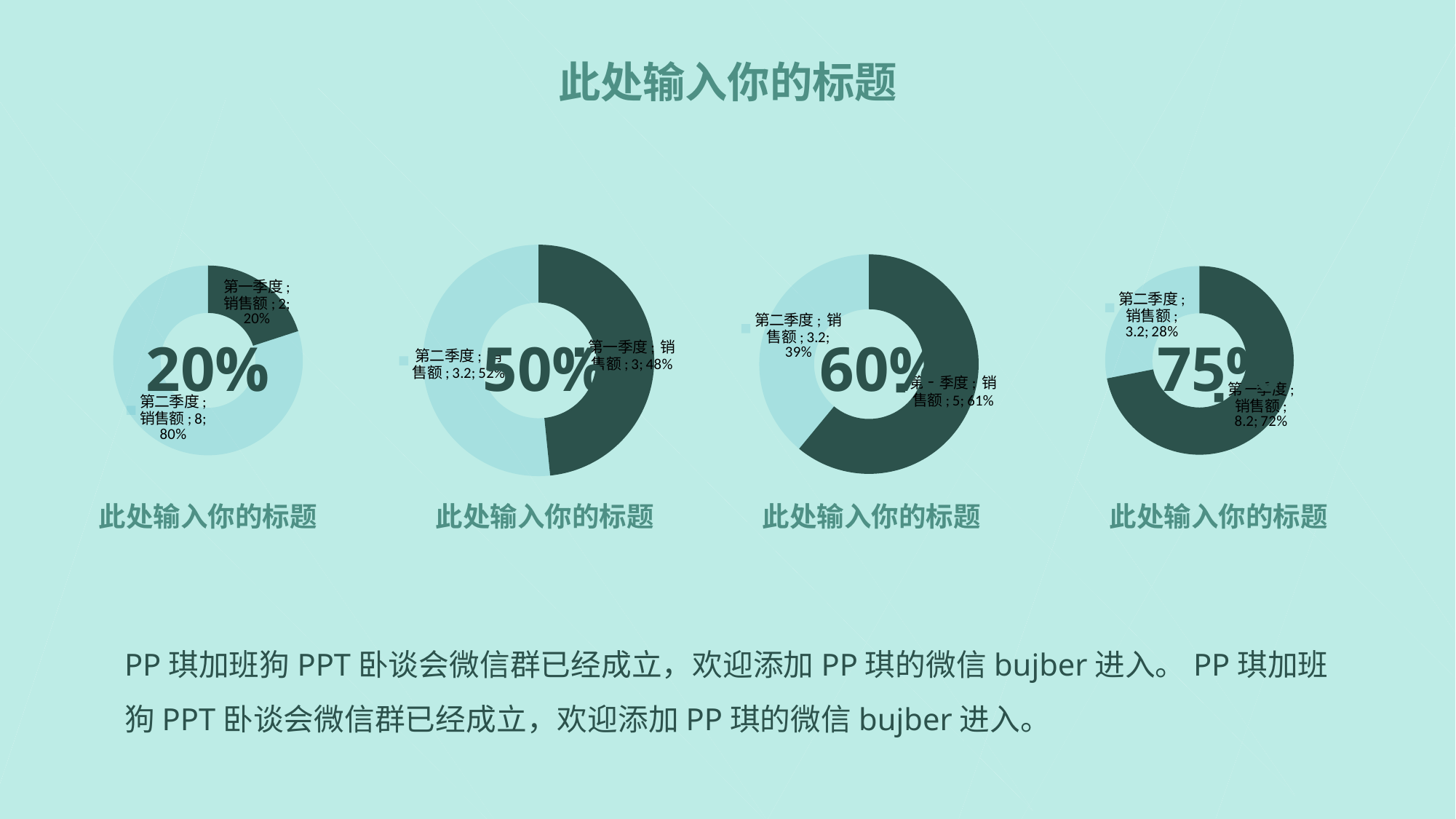
In the rightmost doughnut chart, what is the 销售额 value for 第一季度? 8.2 In the second doughnut chart from the left, what percentage share is shown for 第一季度? 48% In the third doughnut chart from the left, what is the difference between the 第一季度 value and the 第二季度 value? 1.8 What kind of chart is the leftmost chart on the slide? Doughnut chart How many categories does the rightmost doughnut chart show? 2 In the third doughnut chart from the left, what is the 销售额 value for 第一季度? 5 In the rightmost doughnut chart, what share of the total does 第二季度 account for? 28% In the second doughnut chart from the left, what is the 销售额 value for 第二季度? 3.2 In the third doughnut chart from the left, which category has the smallest value? 第二季度 In the leftmost doughnut chart, what share of the total does 第二季度 account for? 80% In the leftmost doughnut chart, what is the 销售额 value for 第一季度? 2 In the leftmost doughnut chart, which category has the larger value, 第一季度 or 第二季度? 第二季度